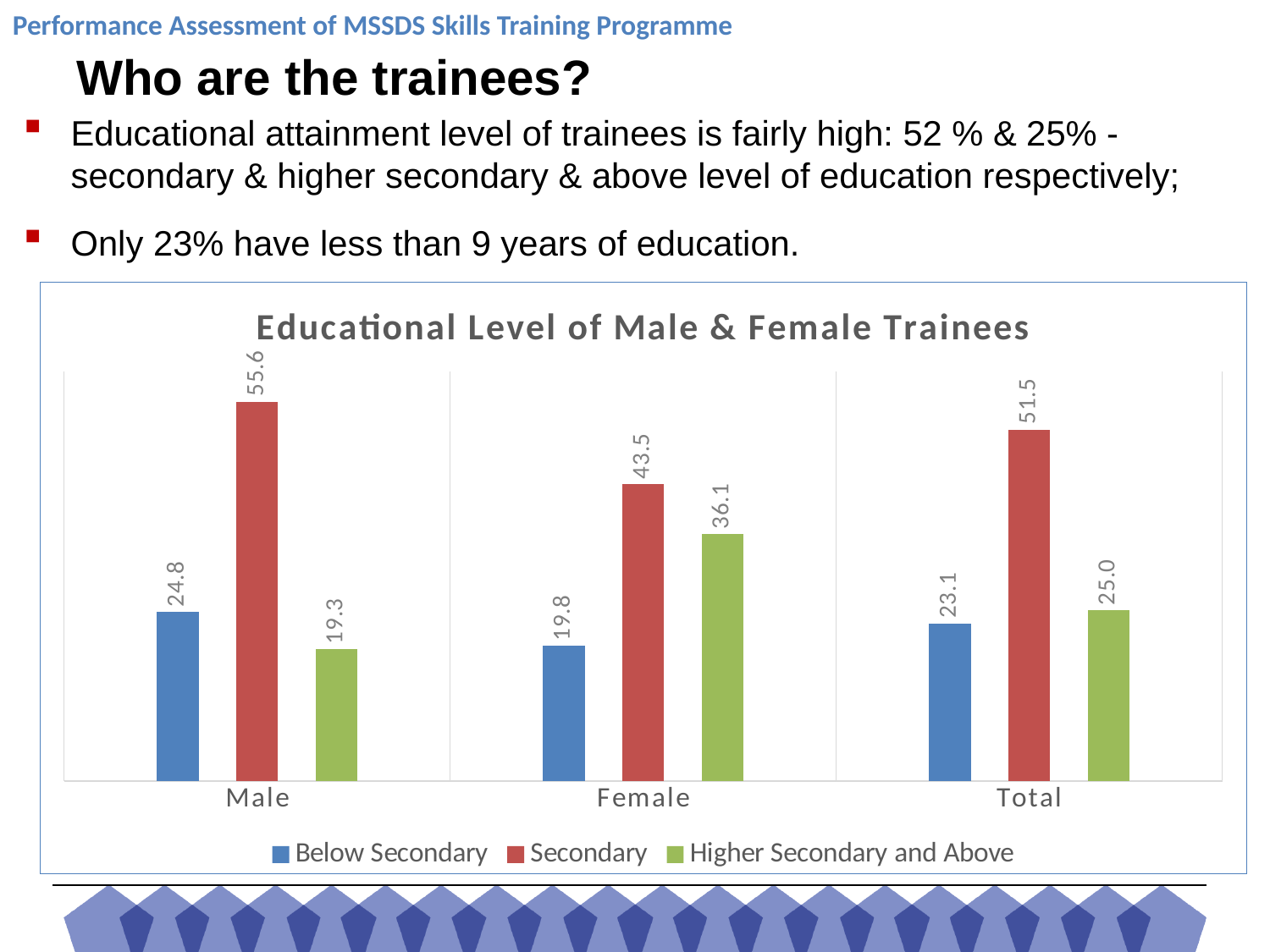
What is the title of the chart? Educational Level of Male & Female Trainees What is the value for Secondary in the Male category? 55.6 What is the value for Higher Secondary and Above in the Female category? 36.1 What kind of chart is shown on the slide? Bar chart Which category has the highest value for Secondary? Male Which category has the lowest value for Higher Secondary and Above? Male What colour are the Secondary bars? Red How many series does the legend list? 3 How many categories are shown on the x axis? 3 What is the difference between the Secondary values for Male and Female? 12.1 What is the value for Below Secondary in the Total category? 23.1 Which is larger: Below Secondary for Male or Below Secondary for Female? Male